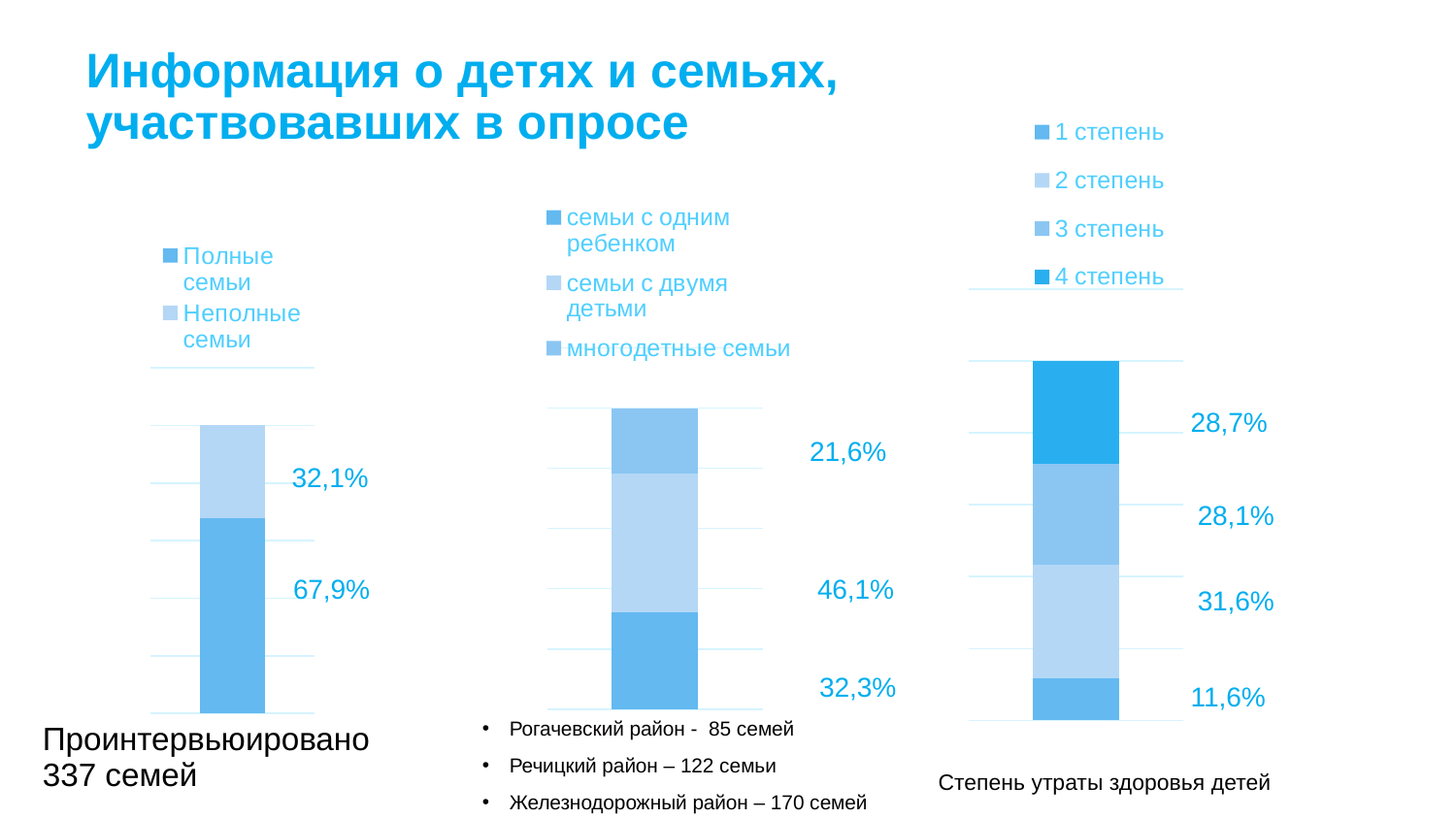
In the middle chart, what is the value for семьи с двумя детьми? 46,1% How many series does the legend of the middle chart list? 3 In the left chart, what is the difference between Полные семьи and Неполные семьи? 35,8% How many series does the legend of the right chart list? 4 In the right chart (Степень утраты здоровья детей), what is the difference between 4 степень and 3 степень? 0,6% In the left chart, what is the value for Полные семьи? 67,9% In the left chart, what is the value for Неполные семьи? 32,1% In the right chart (Степень утраты здоровья детей), which category has the highest value? 2 степень In the middle chart, which category has the lowest value? многодетные семьи In the middle chart, which is larger: семьи с одним ребенком or многодетные семьи? семьи с одним ребенком What kind of chart is the left chart? Stacked bar chart In the right chart (Степень утраты здоровья детей), what is the value for 1 степень? 11,6%